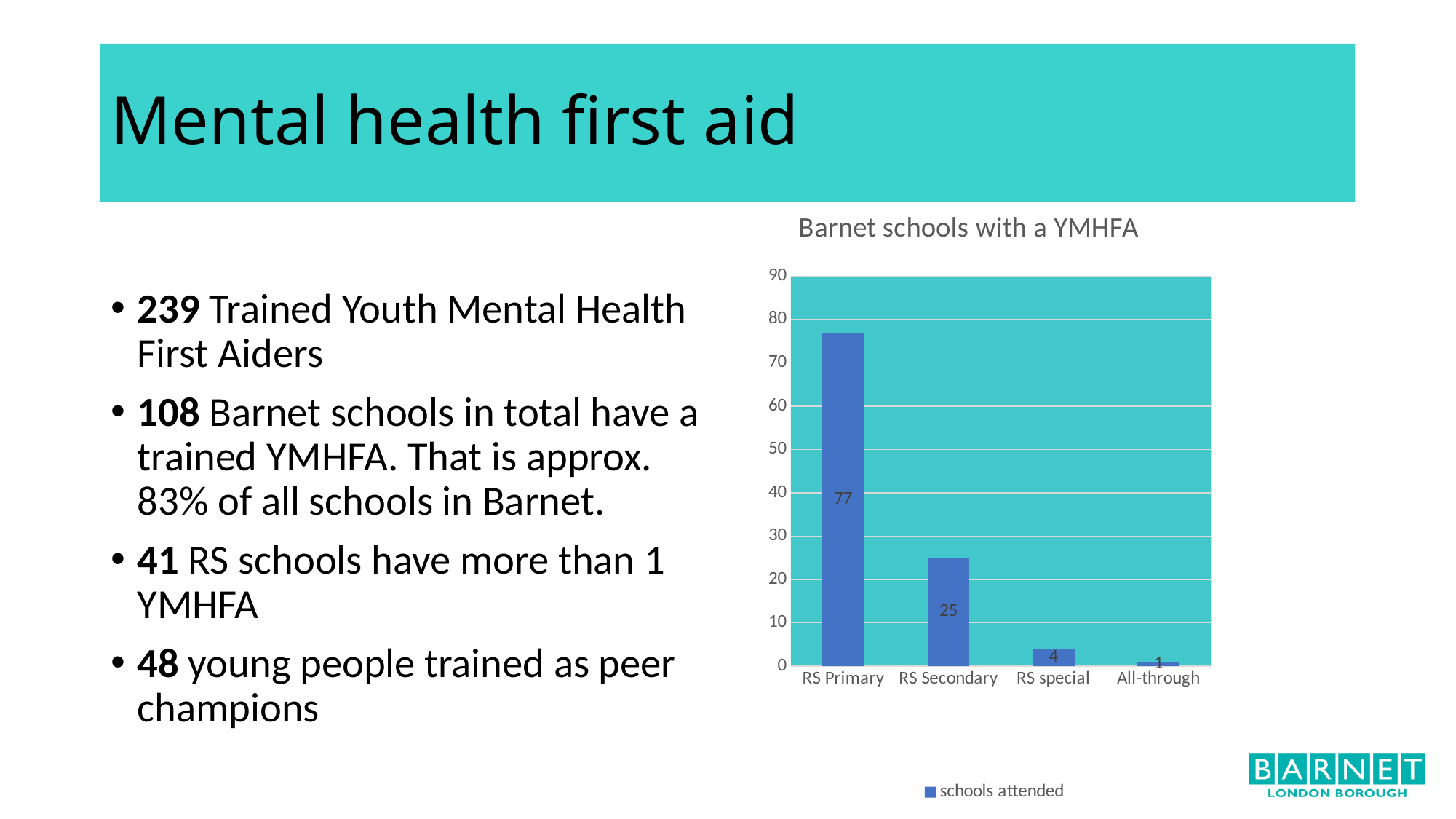
Which category has the highest value? RS Primary Which category has the lowest value? All-through What is the difference between the values for RS Primary and RS Secondary? 52 What is the value for RS Primary? 77 Is the value for RS Primary greater or less than 70? greater How many categories are shown on the x axis? 4 What is the title of the chart? Barnet schools with a YMHFA What is the value for All-through? 1 What is the value for RS special? 4 Which is larger, the value for RS Secondary or the value for RS special? RS Secondary What is the value for RS Secondary? 25 What kind of chart is shown on the slide? bar chart